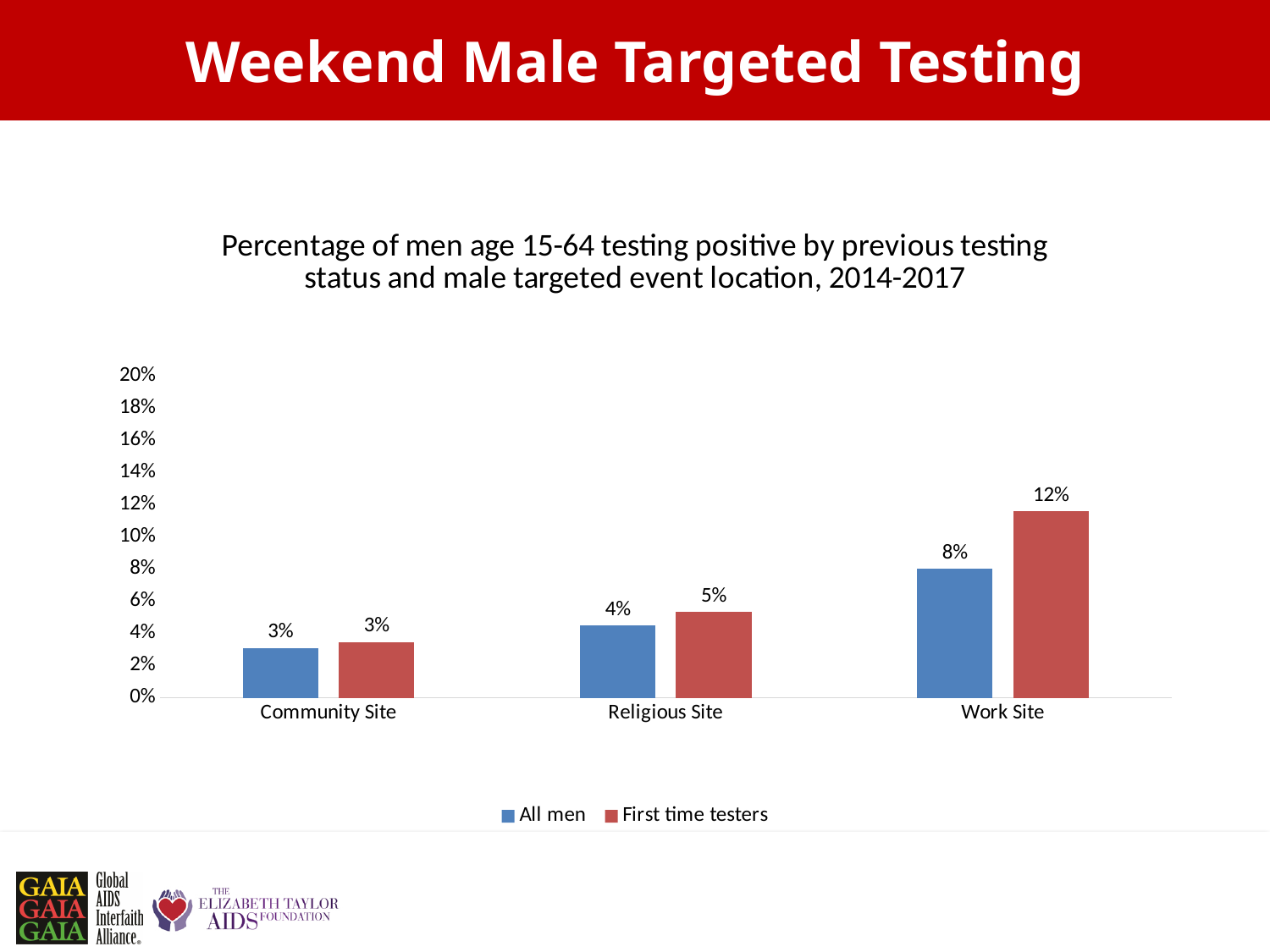
What kind of chart is shown? Bar chart Which site has the highest value for First time testers? Work Site Which is larger at the Religious Site: All men or First time testers? First time testers How many site categories are shown on the x axis? 3 What is the difference between First time testers and All men at the Work Site? 4% How many series does the legend list? 2 Do the values for All men rise or fall from Community Site to Work Site? Rise Which site has the lowest value for All men? Community Site What is the value for All men at the Community Site? 3% What is the value for All men at the Work Site? 8% Is the value for First time testers at the Work Site greater or less than 10%? greater What is the value for First time testers at the Religious Site? 5%